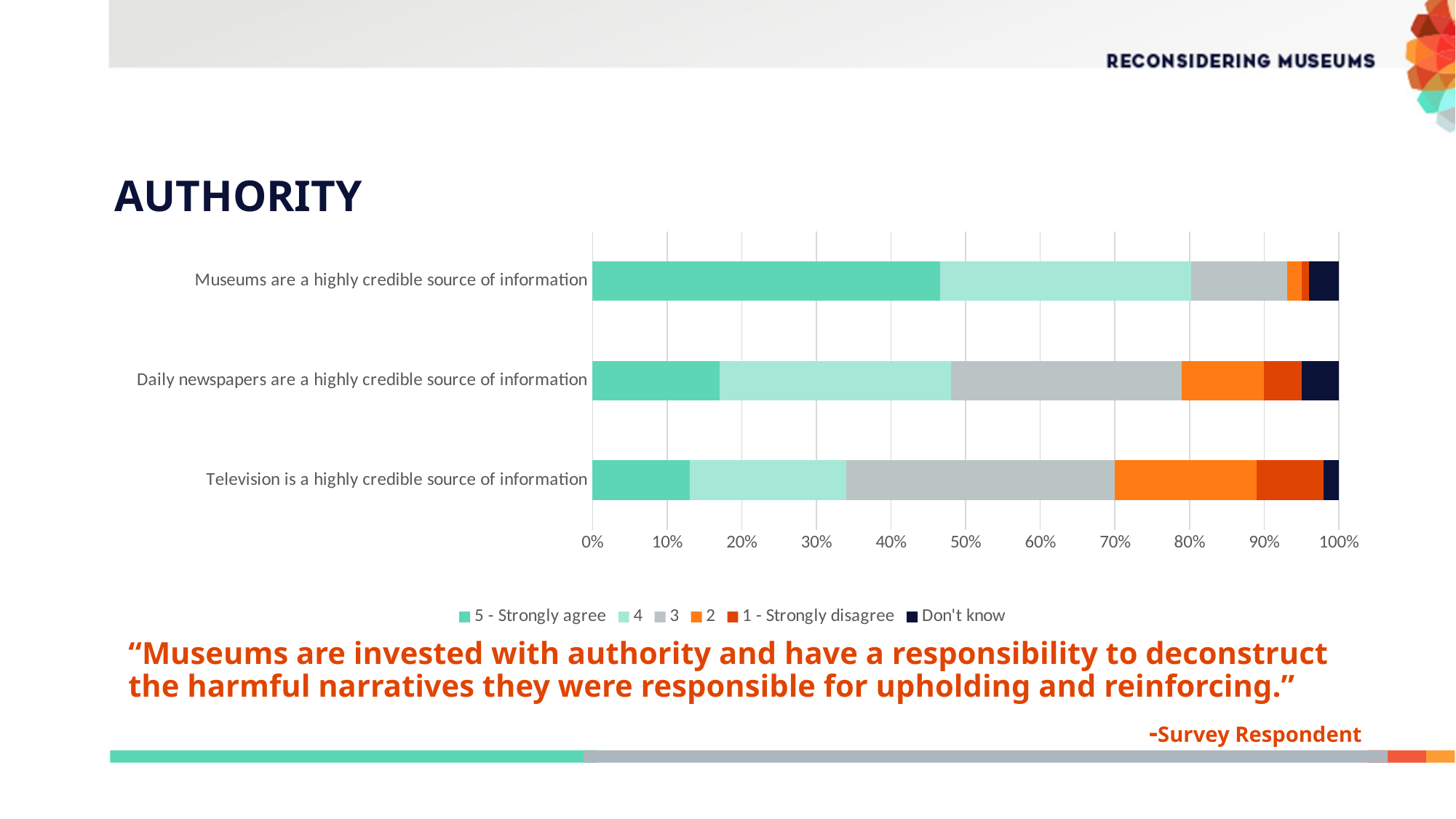
What is the title of the slide containing the chart? AUTHORITY Which statement has the smallest '5 - Strongly agree' segment? Television is a highly credible source of information Is the '5 - Strongly agree' share for 'Museums are a highly credible source of information' greater or less than 40%? greater Is the '5 - Strongly agree' share for 'Daily newspapers are a highly credible source of information' greater or less than 20%? less Is the '5 - Strongly agree' share for 'Television is a highly credible source of information' greater or less than 10%? greater Which has a larger '1 - Strongly disagree' segment: 'Museums are a highly credible source of information' or 'Television is a highly credible source of information'? Television is a highly credible source of information How many series does the chart legend list? 6 What is the last entry in the chart legend? Don't know Which statement has the largest '5 - Strongly agree' segment? Museums are a highly credible source of information How many statements (categories) are plotted in the chart? 3 What kind of chart is shown on the slide? stacked bar chart